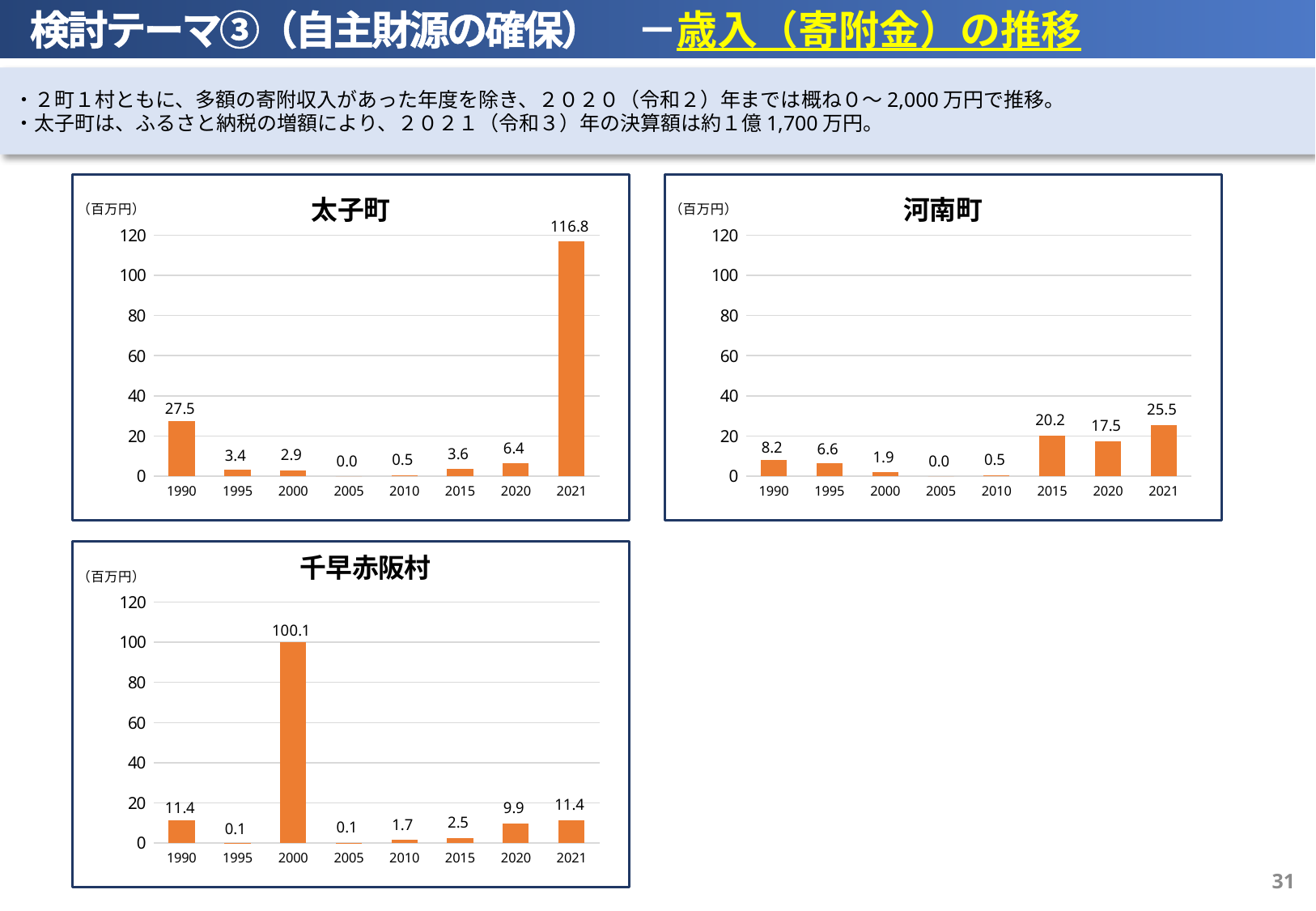
In the 河南町 chart, which year has the highest value? 2021 In the 千早赤阪村 chart, what is the difference between the values for 2020 and 2021? 1.5 In the 太子町 chart, what is the difference between the values for 1990 and 1995? 24.1 How many years are shown on the x axis of the 太子町 chart? 8 What unit is shown in the top-left corner of the 千早赤阪村 chart? 百万円 In the 千早赤阪村 chart, which year has the highest value? 2000 In the 太子町 chart, which year has the highest value? 2021 In the 河南町 chart, what is the value for 2015? 20.2 What type of chart is the 河南町 chart? Bar chart In the 太子町 chart, what is the value for 2021? 116.8 In the 千早赤阪村 chart, what is the value for 2000? 100.1 In the 河南町 chart, which is larger, the value for 2015 or the value for 2020? 2015